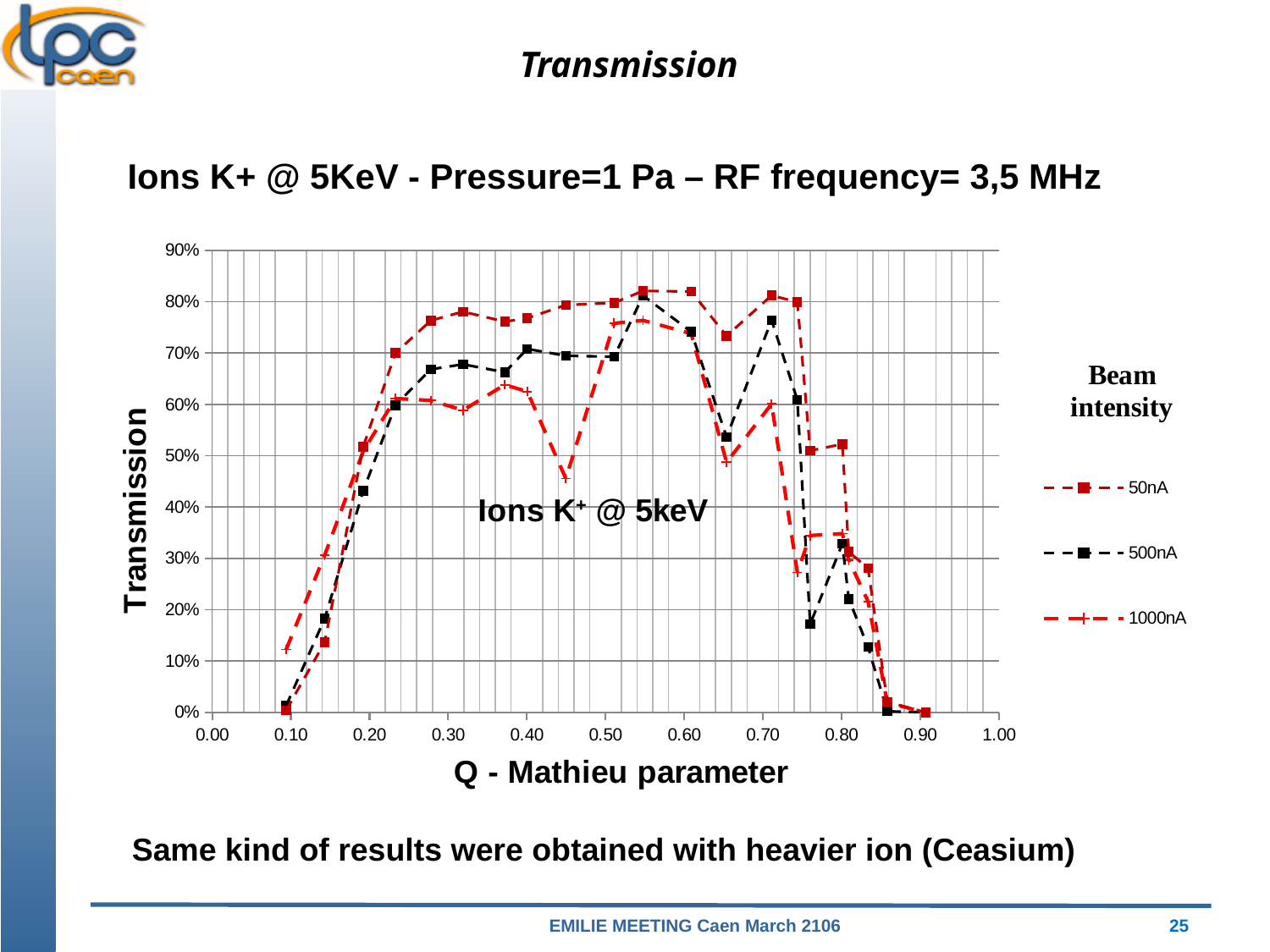
Does the transmission for the 500nA series rise or fall between Q = 0.80 and Q = 0.90? fall What is the label of the x axis? Q - Mathieu parameter At Q = 0.45, which series has the higher transmission, 50nA or 1000nA? 50nA Is the transmission for the 500nA series at Q = 0.76 greater or less than 20%? less What kind of chart is shown on the slide? line chart Is the transmission for the 50nA series at Q = 0.28 greater or less than 70%? greater Does the transmission for the 50nA series rise or fall between Q = 0.10 and Q = 0.20? rise How many series does the legend list? 3 Is the transmission for the 1000nA series at Q = 0.45 greater or less than 50%? less Which series reaches the highest transmission on the chart? 50nA What is the title of the legend? Beam intensity At Q = 0.76, which series has the higher transmission, 500nA or 1000nA? 1000nA